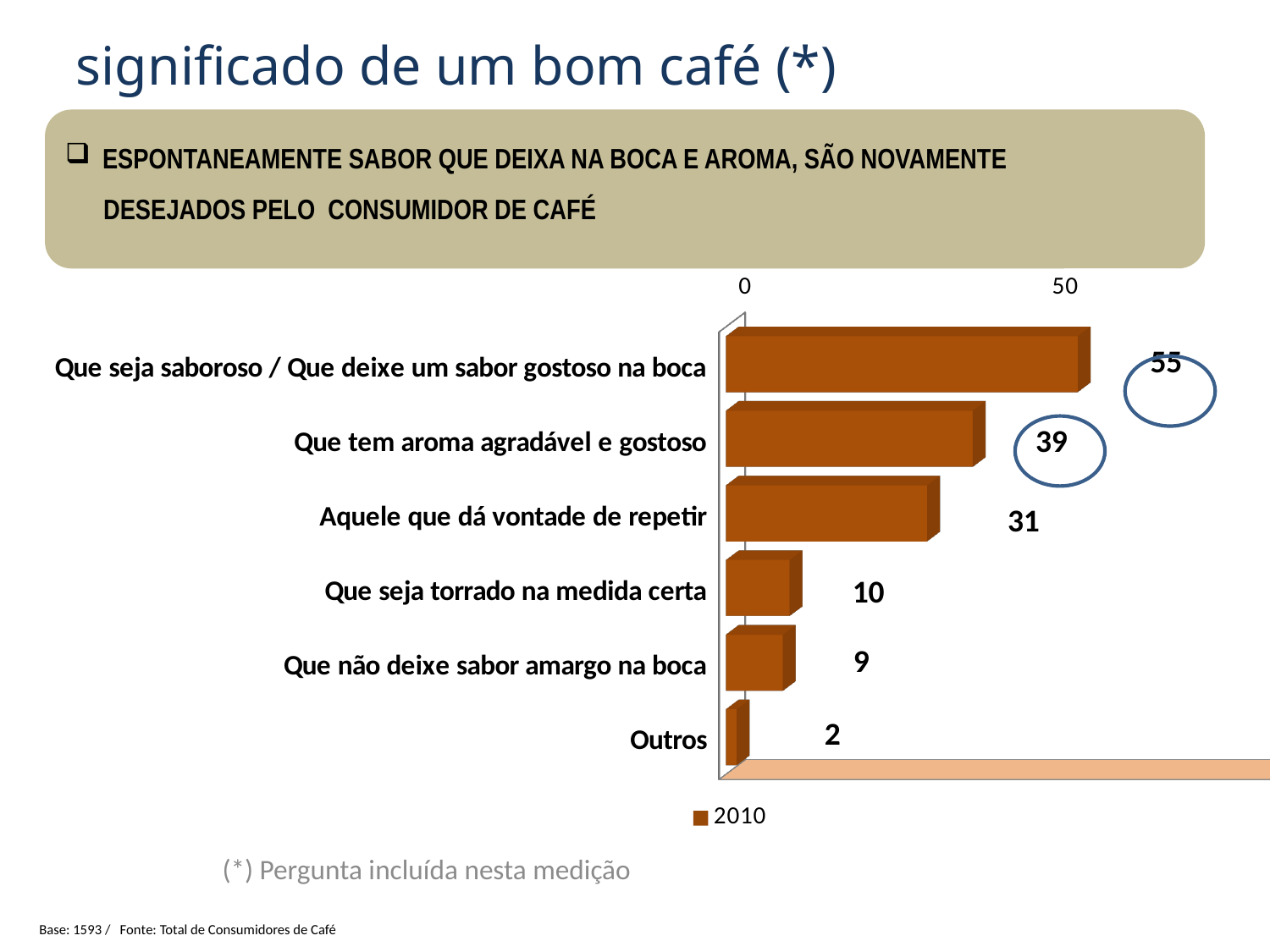
What is the value for "Aquele que dá vontade de repetir"? 31 What is the value for "Que seja saboroso / Que deixe um sabor gostoso na boca"? 55 Which category has the highest value? Que seja saboroso / Que deixe um sabor gostoso na boca How many series does the legend list? 1 How many categories are shown in the chart? 6 What is the difference between the values for "Que seja saboroso / Que deixe um sabor gostoso na boca" and "Que tem aroma agradável e gostoso"? 16 Which is larger: the value for "Que seja torrado na medida certa" or "Que não deixe sabor amargo na boca"? Que seja torrado na medida certa What kind of chart is shown on the slide? Bar chart What is the value for "Que seja torrado na medida certa"? 10 What is the value for "Que tem aroma agradável e gostoso"? 39 What is the value for "Outros"? 2 Which category has the lowest value? Outros